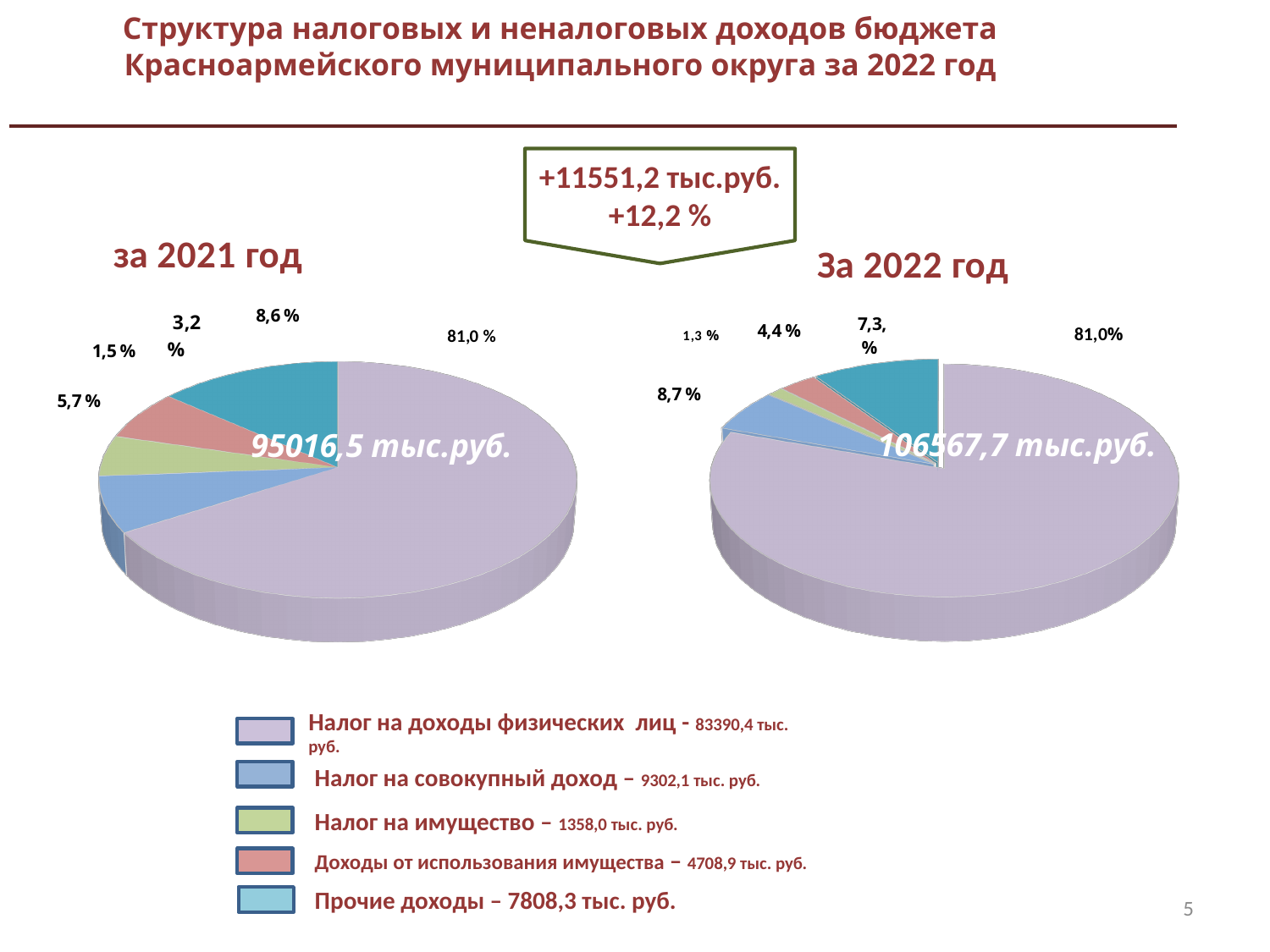
In the 'за 2021 год' pie chart, what share is shown for the largest slice (Налог на доходы физических лиц)? 81,0 % What total amount is printed in the centre of the 'за 2021 год' pie chart? 95016,5 тыс.руб. What kind of chart is used for the 2021 and 2022 data on this slide? Pie chart In the 'за 2021 год' pie chart, which category has the smallest share? Налог на имущество (1,5 %) What total amount is printed in the centre of the 'За 2022 год' pie chart? 106567,7 тыс.руб. Which is larger: the share of Налог на совокупный доход in the 2021 pie chart or in the 2022 pie chart? 2022 (8,7 % vs 5,7 %) What is the difference between the share of Прочие доходы in the 2021 pie chart and in the 2022 pie chart? 1,3 % In the 'За 2022 год' pie chart, what share is shown for Налог на совокупный доход (the blue slice)? 8,7 % In the 'За 2022 год' pie chart, which category has the smallest share? Налог на имущество (1,3 %) How many categories does the legend list for the pie charts? 5 In the 'за 2021 год' pie chart, what share is shown for Прочие доходы (the teal slice)? 8,6 % In the 'За 2022 год' pie chart, what share is shown for Прочие доходы (the teal slice)? 7,3 %